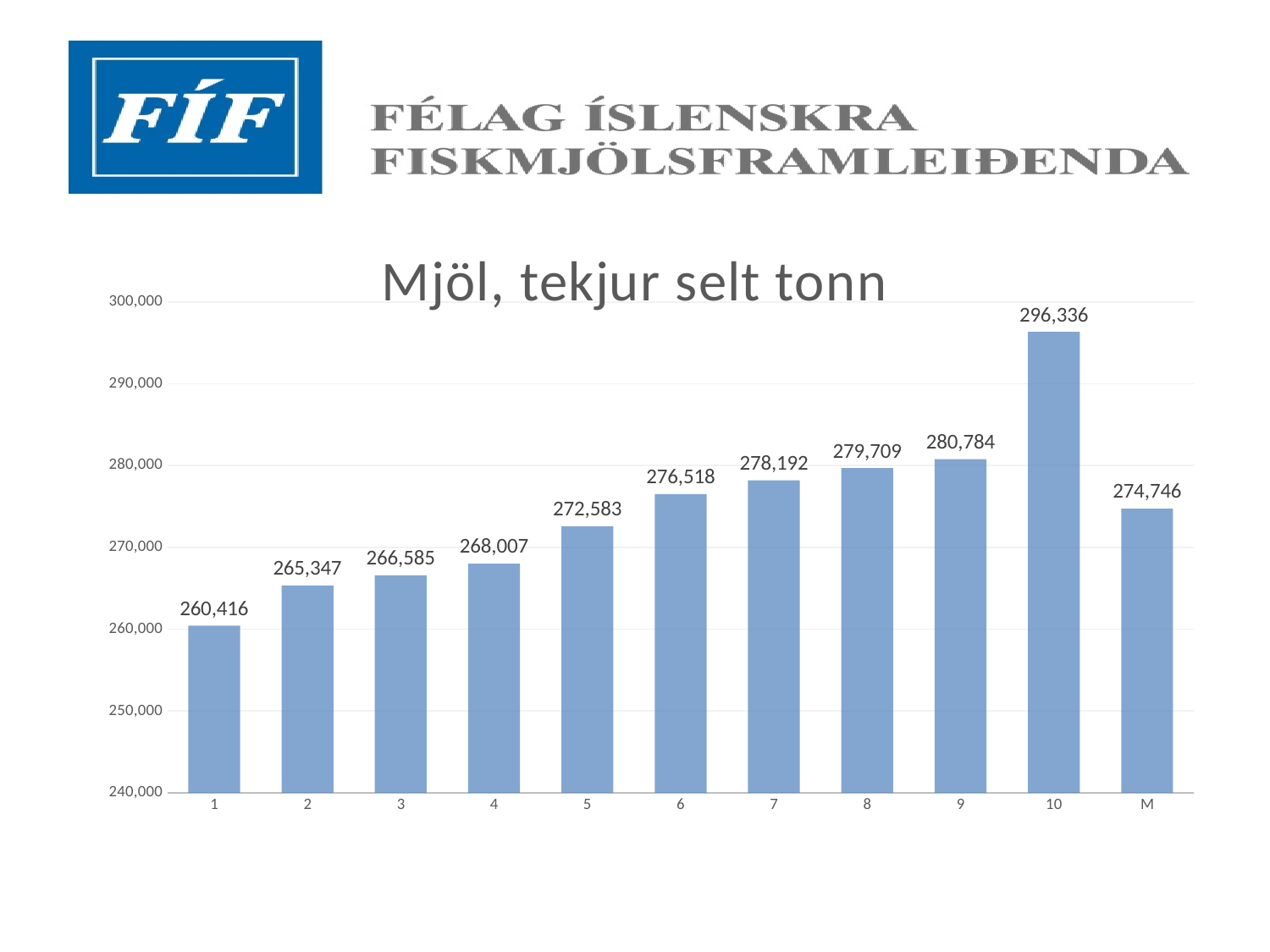
What kind of chart is shown on the slide? bar chart Is the value for category 8 greater or less than 270,000? greater What is the value for category M? 274,746 What is the title of the chart? Mjöl, tekjur selt tonn Which category has the lowest value? 1 What is the value for category 6? 276,518 Which is larger, the value for category 5 or the value for category M? M What is the difference between the values for category 10 and category 9? 15,552 How many bars are shown in the chart? 11 What is the difference between the values for category 2 and category 1? 4,931 What is the value for category 1? 260,416 Which category has the highest value? 10